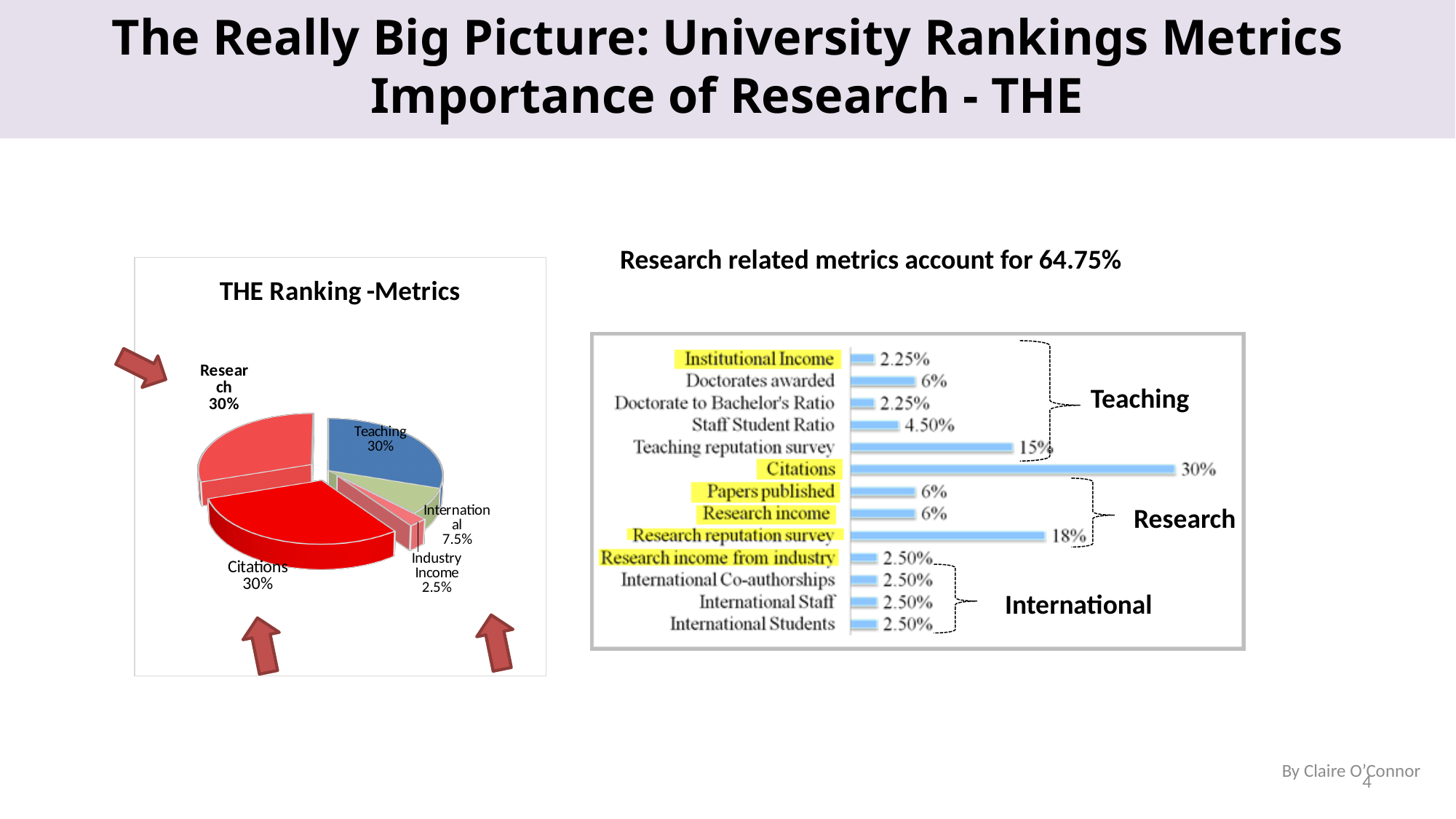
In the bar chart on the right, how many metrics are listed? 13 In the bar chart on the right, what is the difference between Citations and Doctorates awarded? 24% In the bar chart on the right, which metric has the highest value? Citations In the bar chart on the right, which is larger: Teaching reputation survey or Research reputation survey? Research reputation survey In the pie chart titled 'THE Ranking -Metrics', which category has the smallest share? Industry Income In the pie chart titled 'THE Ranking -Metrics', what share does Teaching have? 30% In the bar chart on the right, what is the value for Staff Student Ratio? 4.50% In the bar chart on the right, what is the value for Research reputation survey? 18% In the pie chart titled 'THE Ranking -Metrics', what is the difference between the International share and the Industry Income share? 5% What kind of chart is the chart on the right side of the slide? Bar chart In the pie chart titled 'THE Ranking -Metrics', what share does Industry Income have? 2.5% In the pie chart titled 'THE Ranking -Metrics', how many slices are there? 5